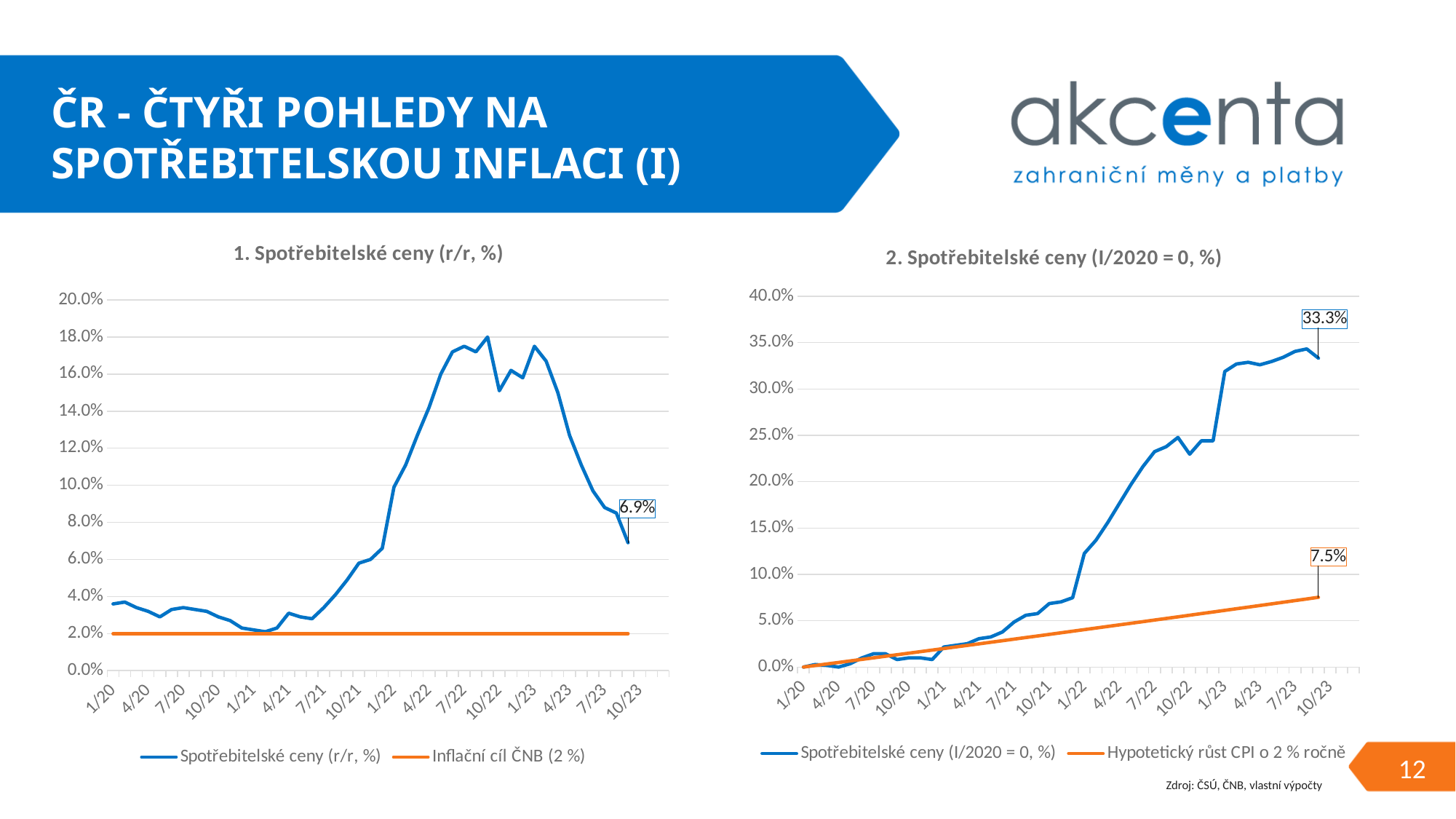
What kind of chart is "1. Spotřebitelské ceny (r/r, %)"? Line chart In the chart titled "1. Spotřebitelské ceny (r/r, %)", does the consumer price series rise or fall between 1/23 and 10/23? Fall In the chart titled "1. Spotřebitelské ceny (r/r, %)", is the value of the consumer price series at 1/21 greater or less than 4.0%? less In the chart titled "2. Spotřebitelské ceny (I/2020 = 0, %)", what is the labelled value of the consumer price series at 10/23? 33.3% In the chart titled "1. Spotřebitelské ceny (r/r, %)", what is the labelled value of the consumer price series at the last point (10/23)? 6.9% In the chart titled "2. Spotřebitelské ceny (I/2020 = 0, %)", does the consumer price series generally rise or fall from 1/20 to 10/23? Rise In the chart titled "1. Spotřebitelské ceny (r/r, %)", what is the name of the series drawn in orange? Inflační cíl ČNB (2 %) In the chart titled "2. Spotřebitelské ceny (I/2020 = 0, %)", what is the labelled value of the "Hypotetický růst CPI o 2 % ročně" line at 10/23? 7.5% In the chart titled "1. Spotřebitelské ceny (r/r, %)", is the peak value of the consumer price series greater or less than 16.0%? greater In the chart titled "2. Spotřebitelské ceny (I/2020 = 0, %)", which series is higher at 10/23: "Spotřebitelské ceny (I/2020 = 0, %)" or "Hypotetický růst CPI o 2 % ročně"? Spotřebitelské ceny (I/2020 = 0, %) In the chart titled "2. Spotřebitelské ceny (I/2020 = 0, %)", what is the difference between the two labelled values at 10/23 (33.3% and 7.5%)? 25.8% How many series does the legend of the chart titled "2. Spotřebitelské ceny (I/2020 = 0, %)" list? 2